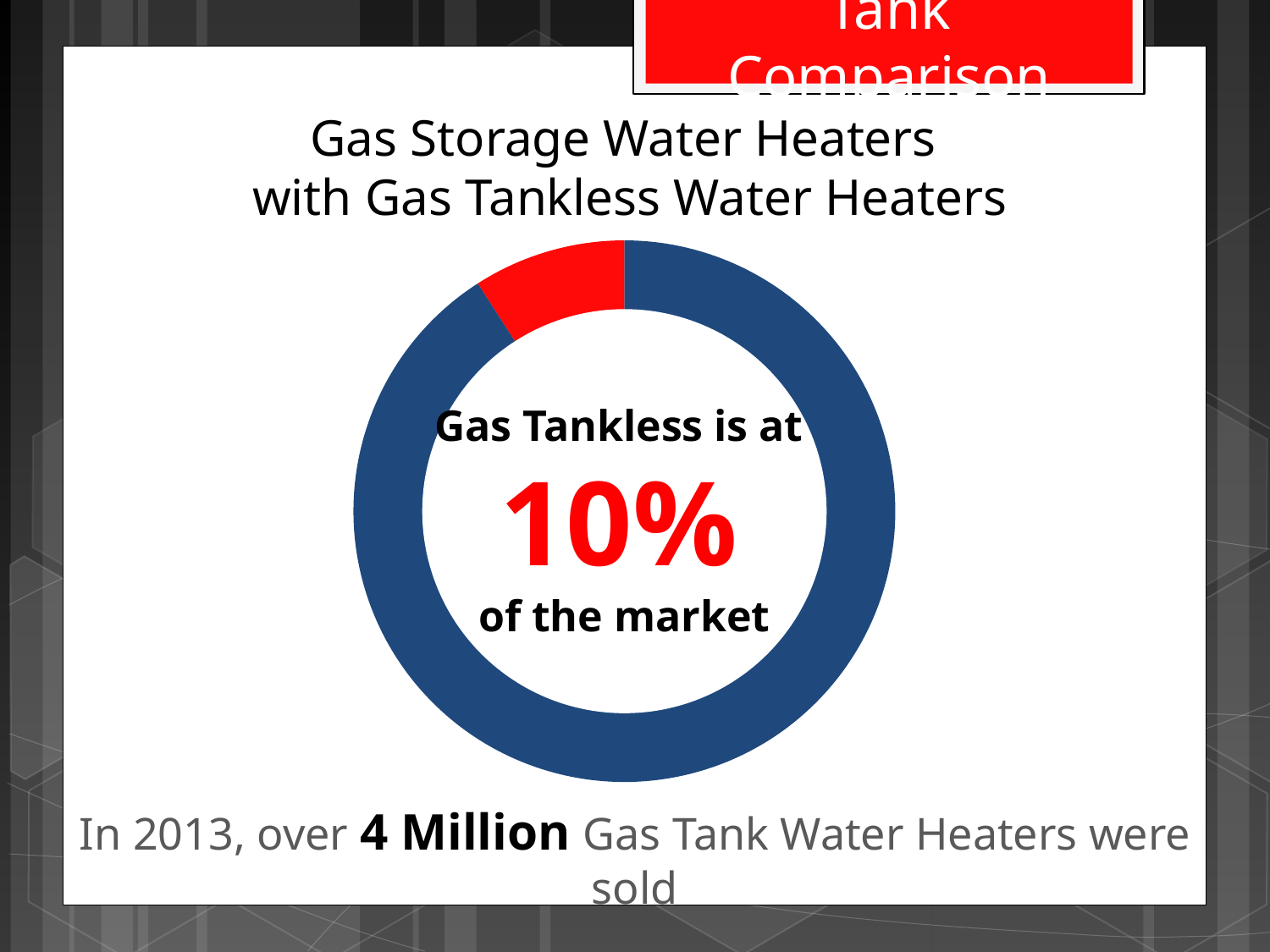
According to the text below the chart, how many Gas Tank Water Heaters were sold in 2013? Over 4 Million What is the title printed above the doughnut chart? Gas Storage Water Heaters with Gas Tankless Water Heaters Which slice of the doughnut chart is larger, the blue slice or the red slice? The blue slice What colour is the slice representing Gas Tankless water heaters? Red What kind of chart is shown on the slide? Doughnut (pie) chart How many slices does the doughnut chart have? 2 What share of the market does the chart show for Gas Tankless water heaters? 10% Which segment of the chart is the smallest? The red Gas Tankless segment